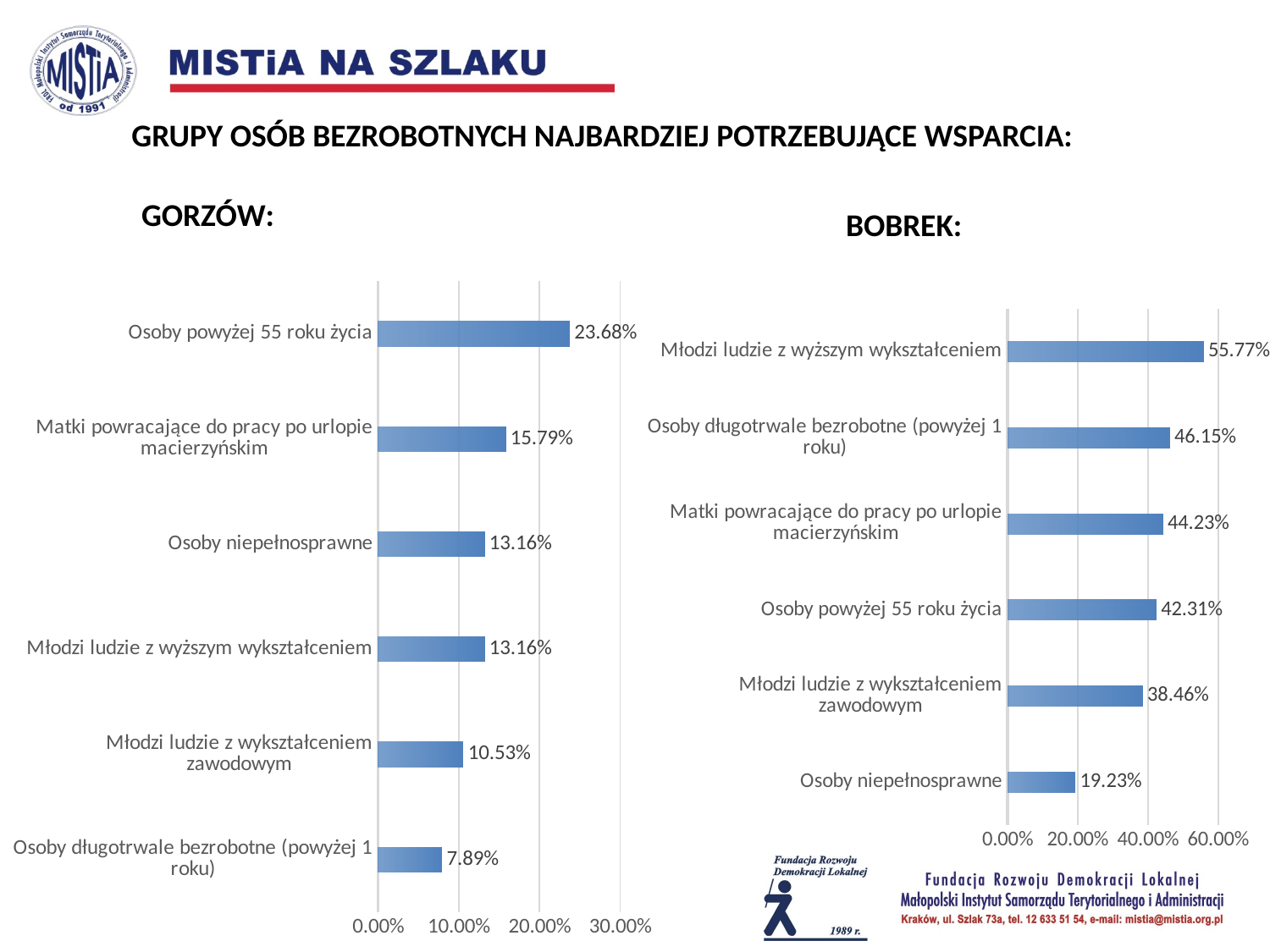
In the BOBREK chart, what is the value for Młodzi ludzie z wyższym wykształceniem? 55.77% In the BOBREK chart, which category has the highest value? Młodzi ludzie z wyższym wykształceniem In the GORZÓW chart, what is the value for Młodzi ludzie z wykształceniem zawodowym? 10.53% In the GORZÓW chart, what is the value for Osoby powyżej 55 roku życia? 23.68% In the GORZÓW chart, which category has the lowest value? Osoby długotrwale bezrobotne (powyżej 1 roku) What kind of chart is the BOBREK chart? Bar chart In the BOBREK chart, which is larger: Osoby długotrwale bezrobotne (powyżej 1 roku) or Osoby powyżej 55 roku życia? Osoby długotrwale bezrobotne (powyżej 1 roku) In the GORZÓW chart, what is the value for Osoby długotrwale bezrobotne (powyżej 1 roku)? 7.89% In the BOBREK chart, what is the difference between Młodzi ludzie z wyższym wykształceniem and Osoby niepełnosprawne? 36.54% How many categories are shown in the GORZÓW chart? 6 In the BOBREK chart, what is the value for Osoby niepełnosprawne? 19.23% In the GORZÓW chart, what is the difference between Osoby powyżej 55 roku życia and Matki powracające do pracy po urlopie macierzyńskim? 7.89%